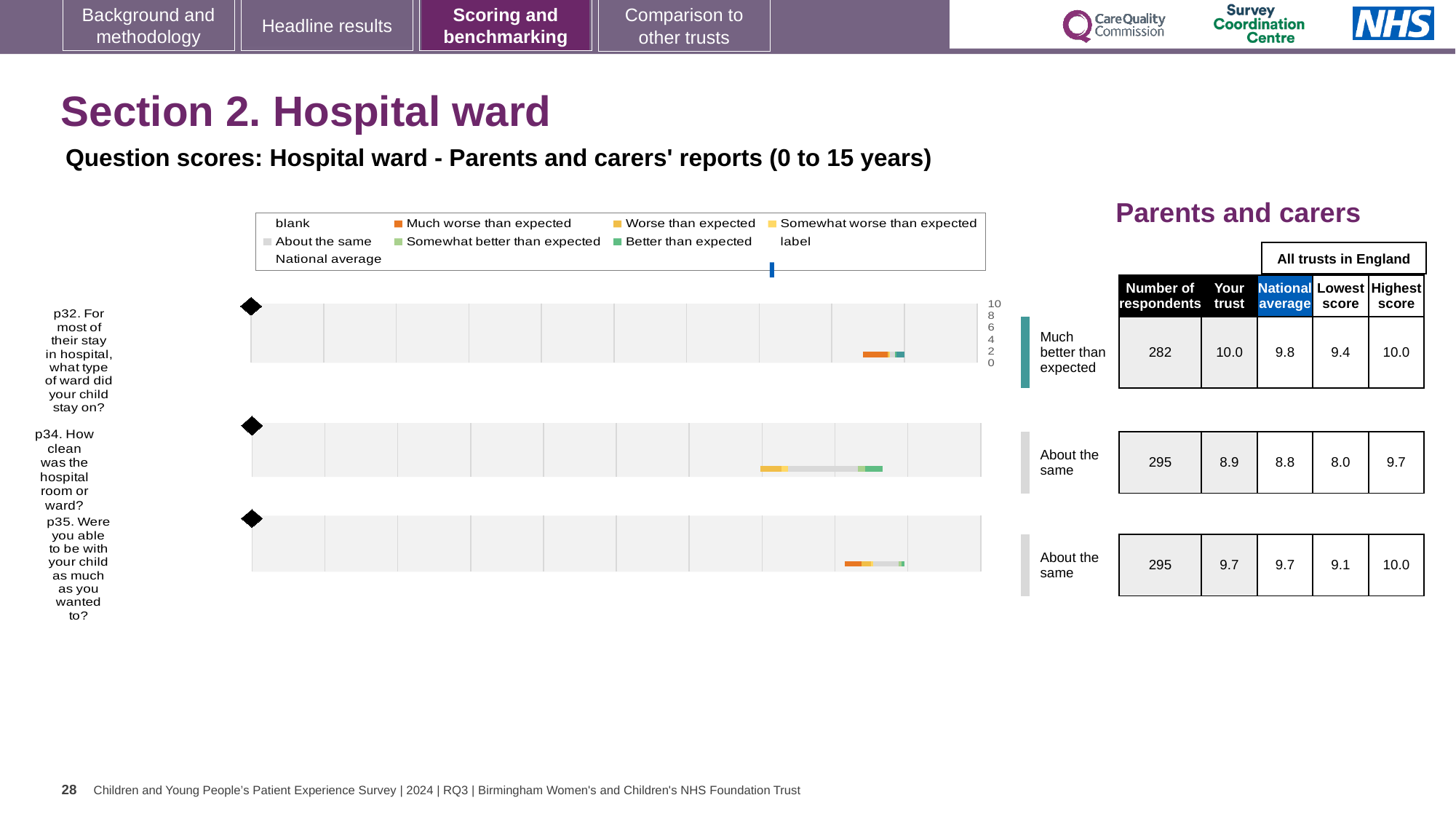
What is the title shown above the table on the right of the chart? Parents and carers In the table, what is the national average for p34 (how clean was the hospital room or ward)? 8.8 How many questions (categories) are plotted in the chart? 3 What is the difference between the highest score and the lowest score for p34 in the table? 1.7 What benchmark category label is shown next to p32 in the chart? Much better than expected In the table, what is the lowest score across all trusts in England for p34? 8.0 In the table, what is the 'Your trust' score for p32 (what type of ward did your child stay on)? 10.0 In the table, how many respondents answered p35 (were you able to be with your child as much as you wanted to)? 295 For p32, which is larger in the table: the 'Your trust' score or the national average? Your trust Which question has the highest 'Your trust' score in the table? p32 Which question has the lowest 'Your trust' score in the table? p34 What kind of chart is used to show the question scores on this slide? bar chart